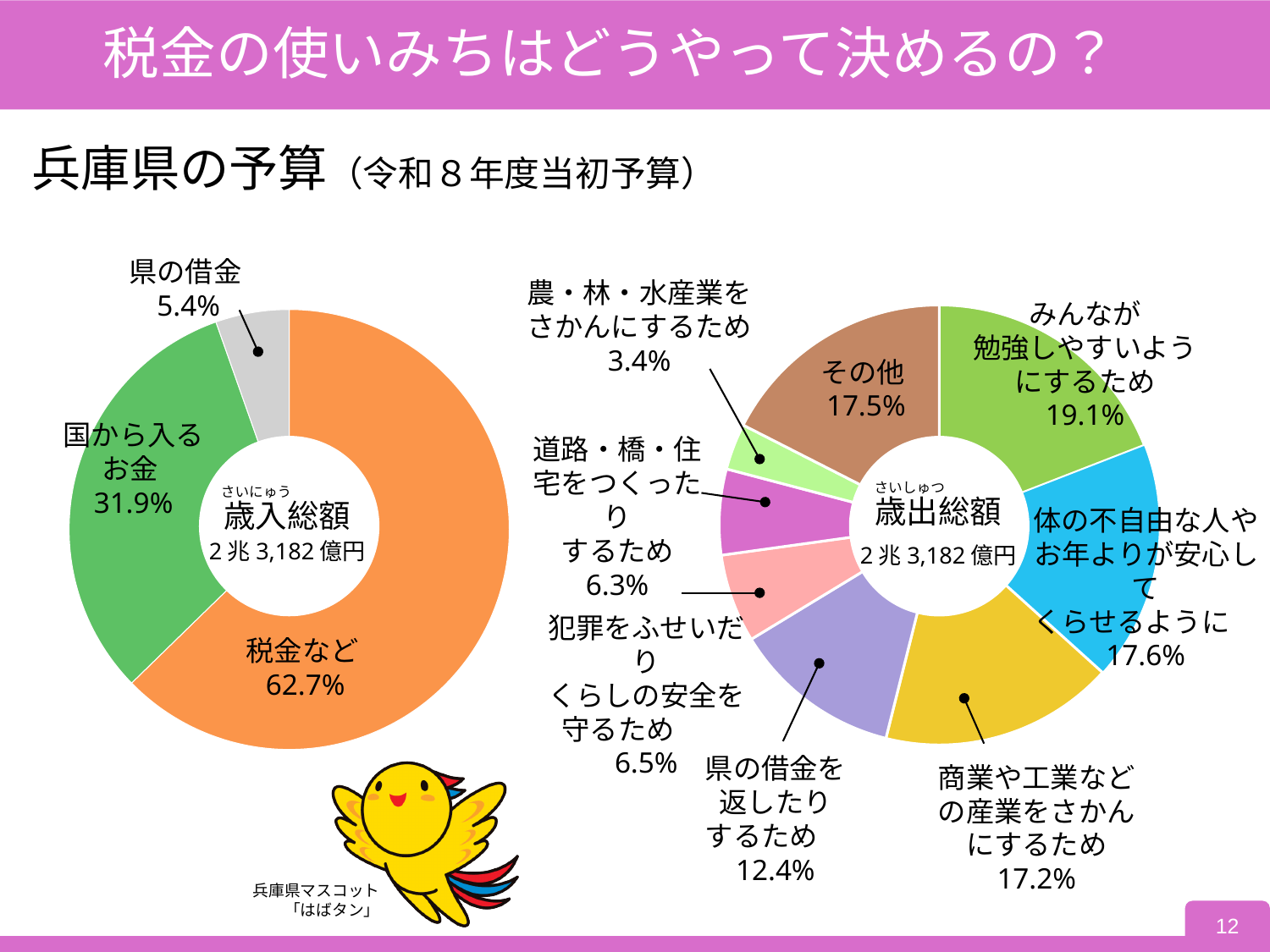
右の「歳出総額」のグラフで、「みんなが勉強しやすいようにするため」の割合はいくらですか？ 19.1% 右の「歳出総額」のグラフで、最も割合が小さい項目は何ですか？ 農・林・水産業をさかんにするため 左の「歳入総額」のグラフには、いくつの項目がありますか？ 3 右の「歳出総額」のグラフは、どのような種類のグラフですか？ 円グラフ（ドーナツグラフ） 左の「歳入総額」のグラフで、最も割合が小さい項目は何ですか？ 県の借金 右の「歳出総額」のグラフで、「県の借金を返したりするため」の割合はいくらですか？ 12.4% 左の「歳入総額」のグラフで、「税金など」の割合はいくらですか？ 62.7% 左の「歳入総額」のグラフで、「国から入るお金」の割合はいくらですか？ 31.9% 左の「歳入総額」のグラフの中央に書かれている総額はいくらですか？ 2兆3,182億円 右の「歳出総額」のグラフで、「その他」と「商業や工業などの産業をさかんにするため」では、どちらの割合が大きいですか？ その他 左の「歳入総額」のグラフで、「税金など」と「国から入るお金」の割合の差は何ポイントですか？ 30.8ポイント 右の「歳出総額」のグラフで、最も割合が大きい項目は何ですか？ みんなが勉強しやすいようにするため